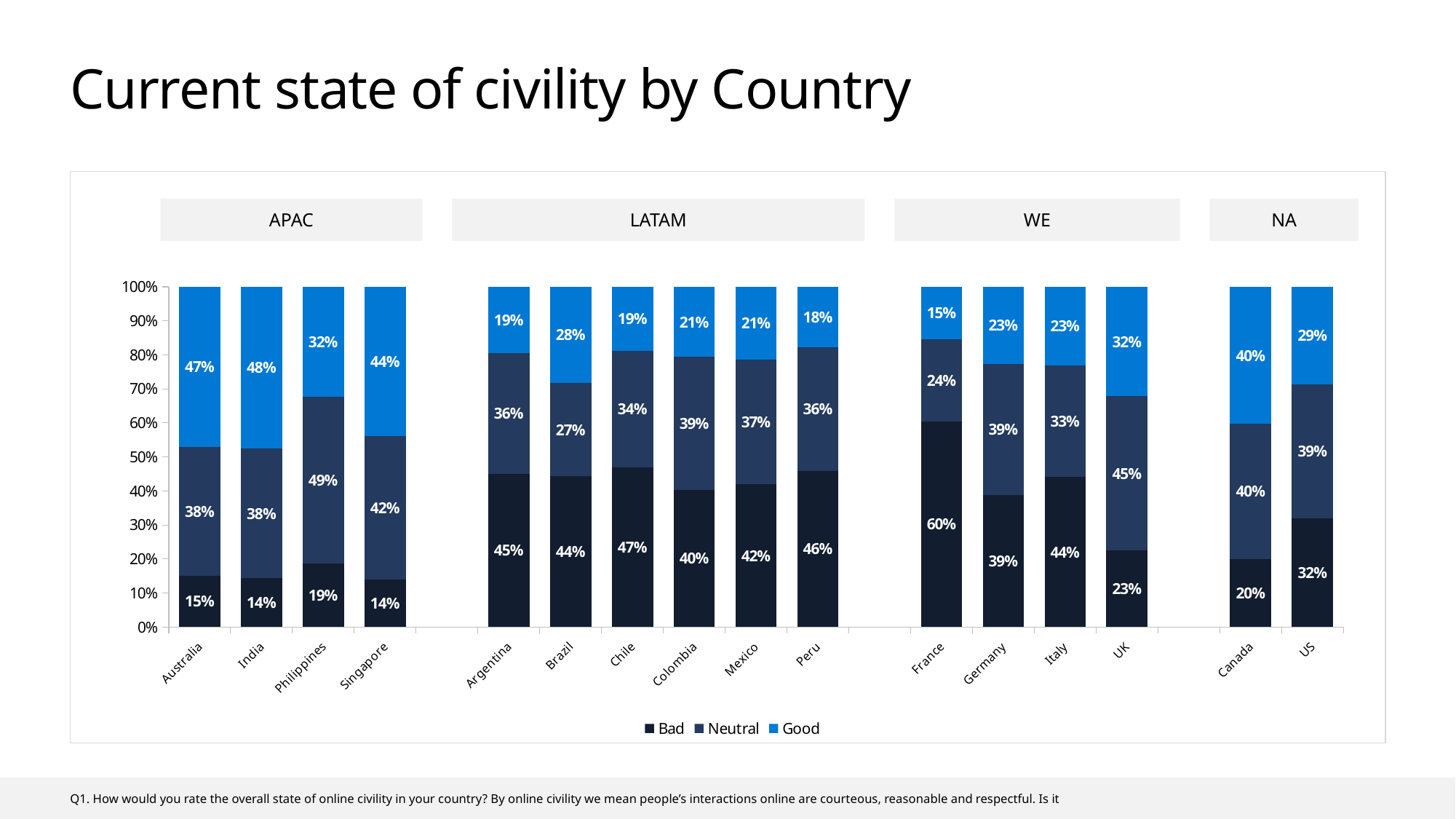
Which country has the highest Bad percentage? France What is the Good value for India? 48% What is the Neutral value for the UK? 45% What kind of chart is shown on the slide? Stacked bar chart How many series does the legend list? 3 What percentage of respondents in France rated online civility as Bad? 60% What is the difference between the Neutral values for Philippines and Brazil? 22% What is the difference between the Good values for Australia and Philippines? 15% Which country has the lowest Good percentage? France How many regional groups are labelled above the chart? 4 Which is larger, the Bad value for the US or the Bad value for Canada? US How many countries are shown on the chart? 16